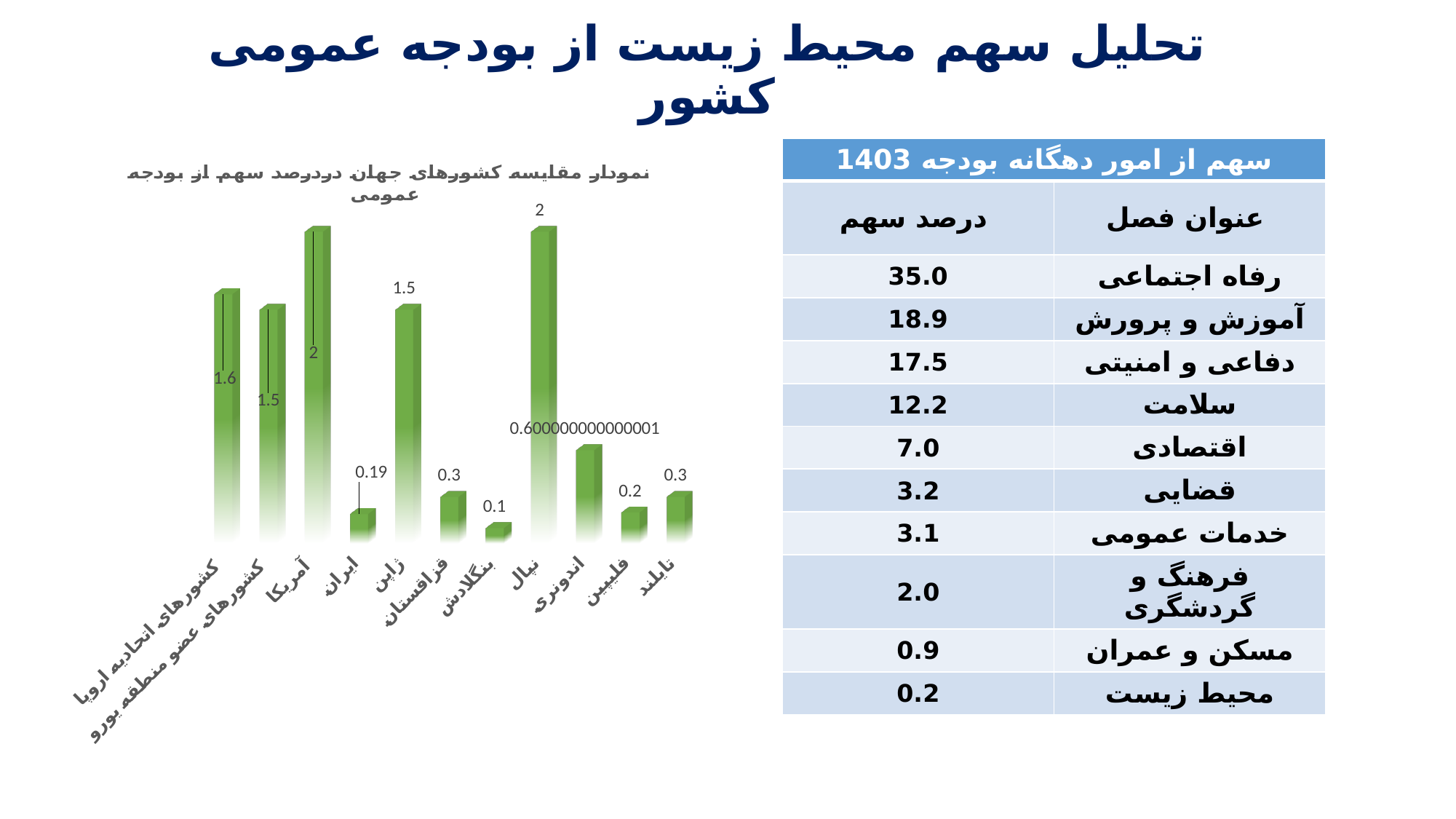
What is the value for بنگلادش in the bar chart? 0.1 Which two categories share the highest value in the bar chart? آمریکا and نپال Which category has the lowest value in the bar chart? بنگلادش What is the difference between the values for آمریکا and ایران in the bar chart? 1.81 What type of chart is shown on the slide? bar chart Which is larger in the bar chart, the value for کشورهای اتحادیه اروپا or the value for کشورهای عضو منطقه یورو? کشورهای اتحادیه اروپا What is the value for کشورهای اتحادیه اروپا in the bar chart? 1.6 How many categories (countries or groups) are shown in the bar chart? 11 What is the value for ژاپن in the bar chart? 1.5 What is the value for ایران in the bar chart? 0.19 What is the value for اندونزی in the bar chart, as printed on the slide? 0.600000000000001 What is the title of the bar chart? نمودار مقایسه کشورهای جهان دردرصد سهم از بودجه عمومی